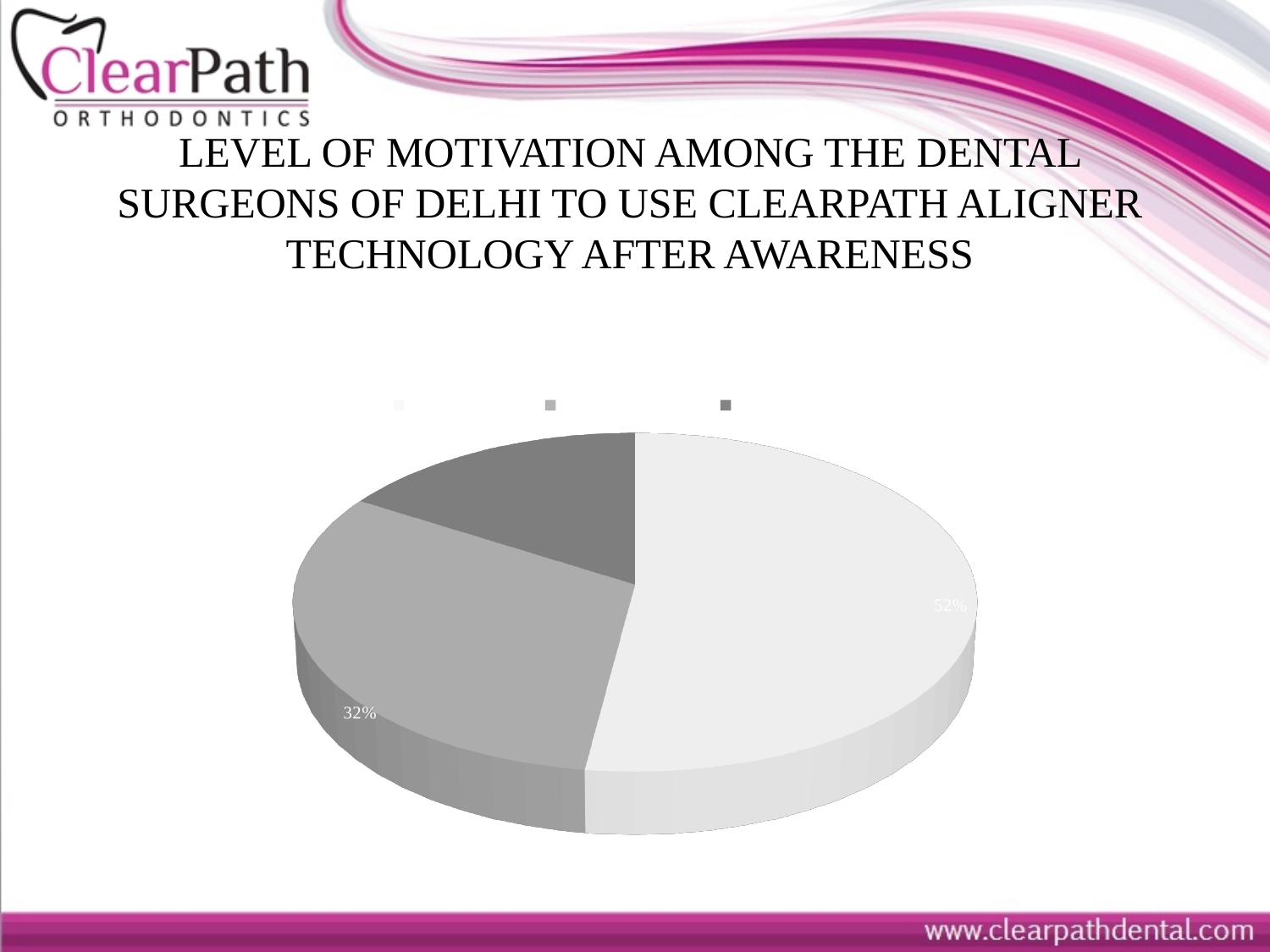
What percentage is printed on the medium grey slice on the lower left of the pie chart? 32% What combined share do the two labelled slices (52% and 32%) account for? 84% What is the difference between the 52% slice and the 32% slice? 20 percentage points Is the dark grey slice at the top of the pie chart greater or less than 25%? less How many entries does the legend above the pie chart show? 3 What is the title shown above the pie chart? LEVEL OF MOTIVATION AMONG THE DENTAL SURGEONS OF DELHI TO USE CLEARPATH ALIGNER TECHNOLOGY AFTER AWARENESS What kind of chart is shown on the slide? pie chart How many slices does the pie chart have? 3 Is the largest slice of the pie chart greater or less than 50%? greater Which slice is larger, the light-coloured slice on the right or the medium grey slice on the lower left? the light-coloured slice on the right What is the value of the largest slice of the pie chart? 52% What percentage is printed on the light-coloured slice on the right of the pie chart? 52%